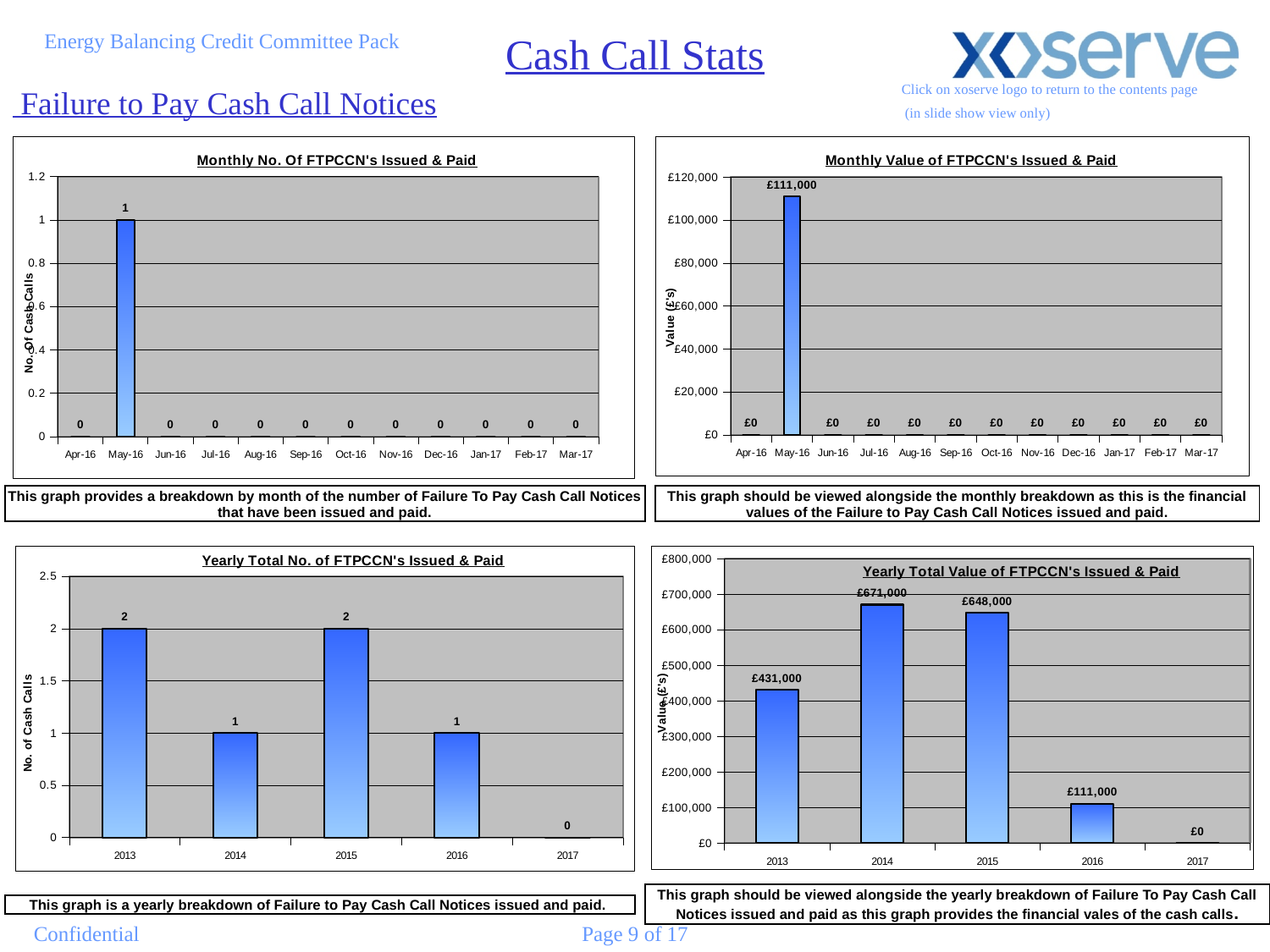
In the 'Monthly No. Of FTPCCN's Issued & Paid' chart, how many months are shown on the x axis? 12 In the 'Yearly Total Value of FTPCCN's Issued & Paid' chart, which is larger, the value for 2013 or the value for 2016? 2013 In the 'Yearly Total Value of FTPCCN's Issued & Paid' chart, is the value for 2015 greater or less than £600,000? greater In the 'Yearly Total No. of FTPCCN's Issued & Paid' chart, how many years are shown? 5 In the 'Yearly Total Value of FTPCCN's Issued & Paid' chart, which year has the highest value? 2014 In the 'Yearly Total Value of FTPCCN's Issued & Paid' chart, what is the value for 2013? £431,000 In the 'Monthly Value of FTPCCN's Issued & Paid' chart, what is the value for May-16? £111,000 In the 'Yearly Total No. of FTPCCN's Issued & Paid' chart, what is the value for 2015? 2 In the 'Yearly Total Value of FTPCCN's Issued & Paid' chart, what is the difference between the 2014 and 2015 values? £23,000 In the 'Monthly No. Of FTPCCN's Issued & Paid' chart, what is the value for May-16? 1 In the 'Yearly Total No. of FTPCCN's Issued & Paid' chart, which year has the lowest value? 2017 What kind of chart is the 'Yearly Total Value of FTPCCN's Issued & Paid' chart? bar chart